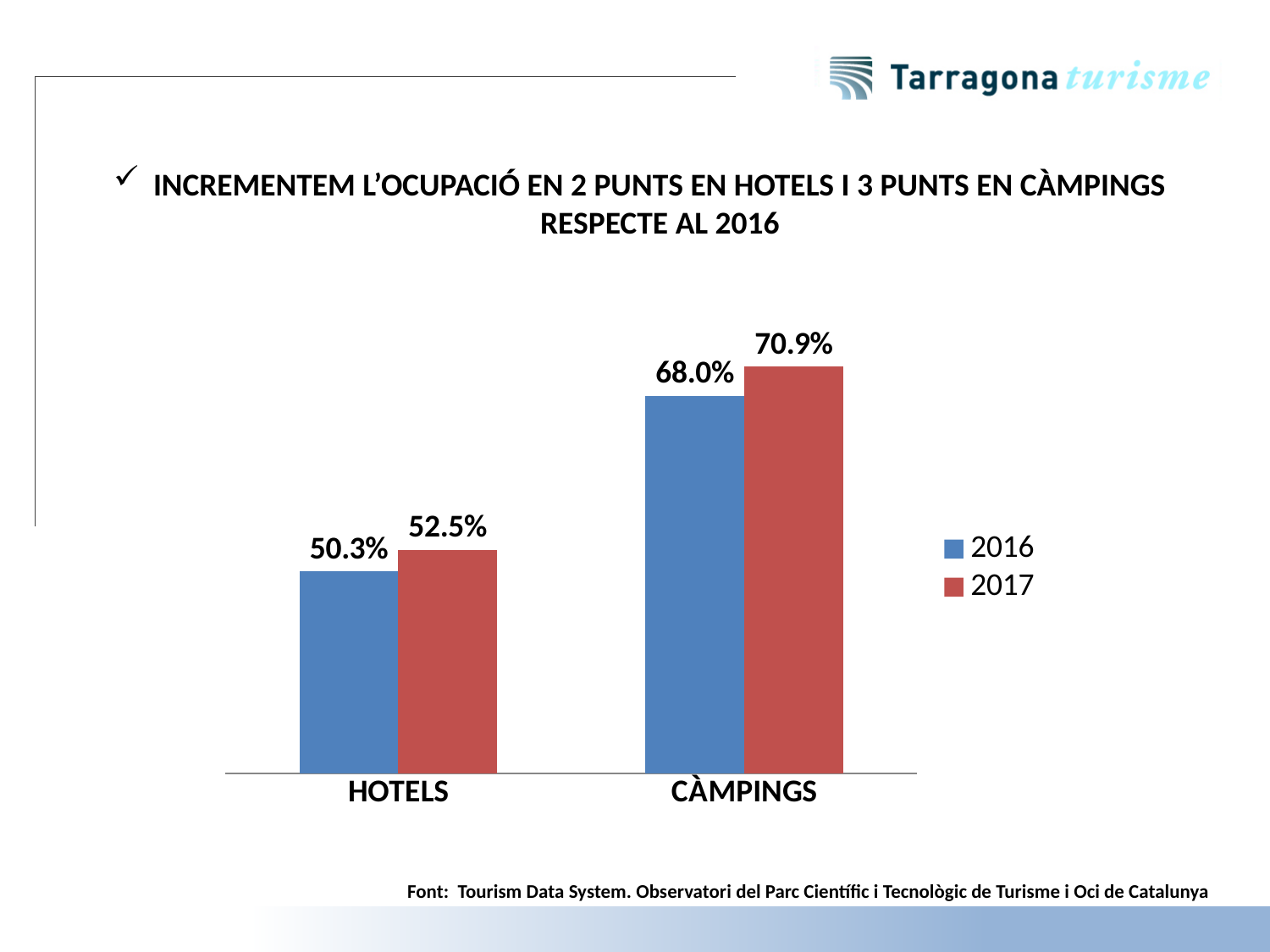
What is the value for CÀMPINGS in 2017? 70.9% Which category has the lowest value in 2016? HOTELS How many categories are shown on the x axis? 2 Which is larger for HOTELS, the 2016 value or the 2017 value? 2017 What is the value for CÀMPINGS in 2016? 68.0% What is the value for HOTELS in 2016? 50.3% What is the difference between the 2017 and 2016 values for CÀMPINGS? 2.9% What kind of chart is shown on the slide? Bar chart Which category has the highest value in 2017? CÀMPINGS What is the value for HOTELS in 2017? 52.5% How many series does the legend list? 2 What is the difference between the 2017 and 2016 values for HOTELS? 2.2%